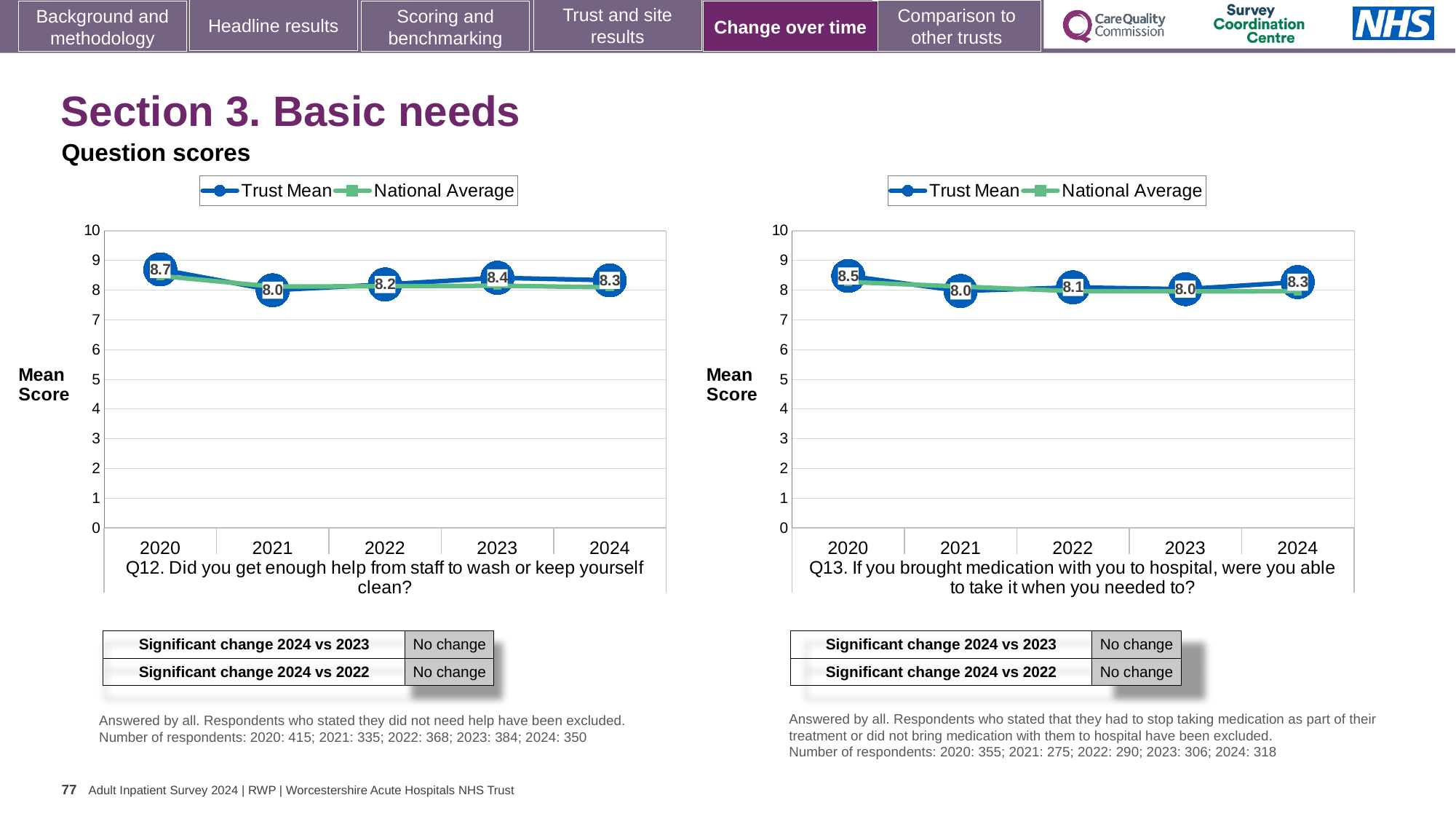
In the Q13 chart (right), is the Trust Mean for 2024 larger or smaller than the Trust Mean for 2023? larger What type of chart is the Q12 chart (left)? Line chart How many years are plotted on the x axis of the Q12 chart (left)? 5 In the Q12 chart (left), what is the difference between the Trust Mean in 2020 and 2021? 0.7 In the Q13 chart (right), what is the Trust Mean for 2022? 8.1 In the Q12 chart (left), what is the Trust Mean for 2020? 8.7 In the Q12 chart (left), which year has the lowest Trust Mean? 2021 In the Q13 chart (right), what is the Trust Mean for 2020? 8.5 In the Q12 chart (left), what is the Trust Mean for 2024? 8.3 How many series does the legend of the Q13 chart (right) list? 2 In the Q13 chart (right), what is the difference between the Trust Mean in 2024 and 2023? 0.3 In the Q13 chart (right), which year has the highest Trust Mean? 2020